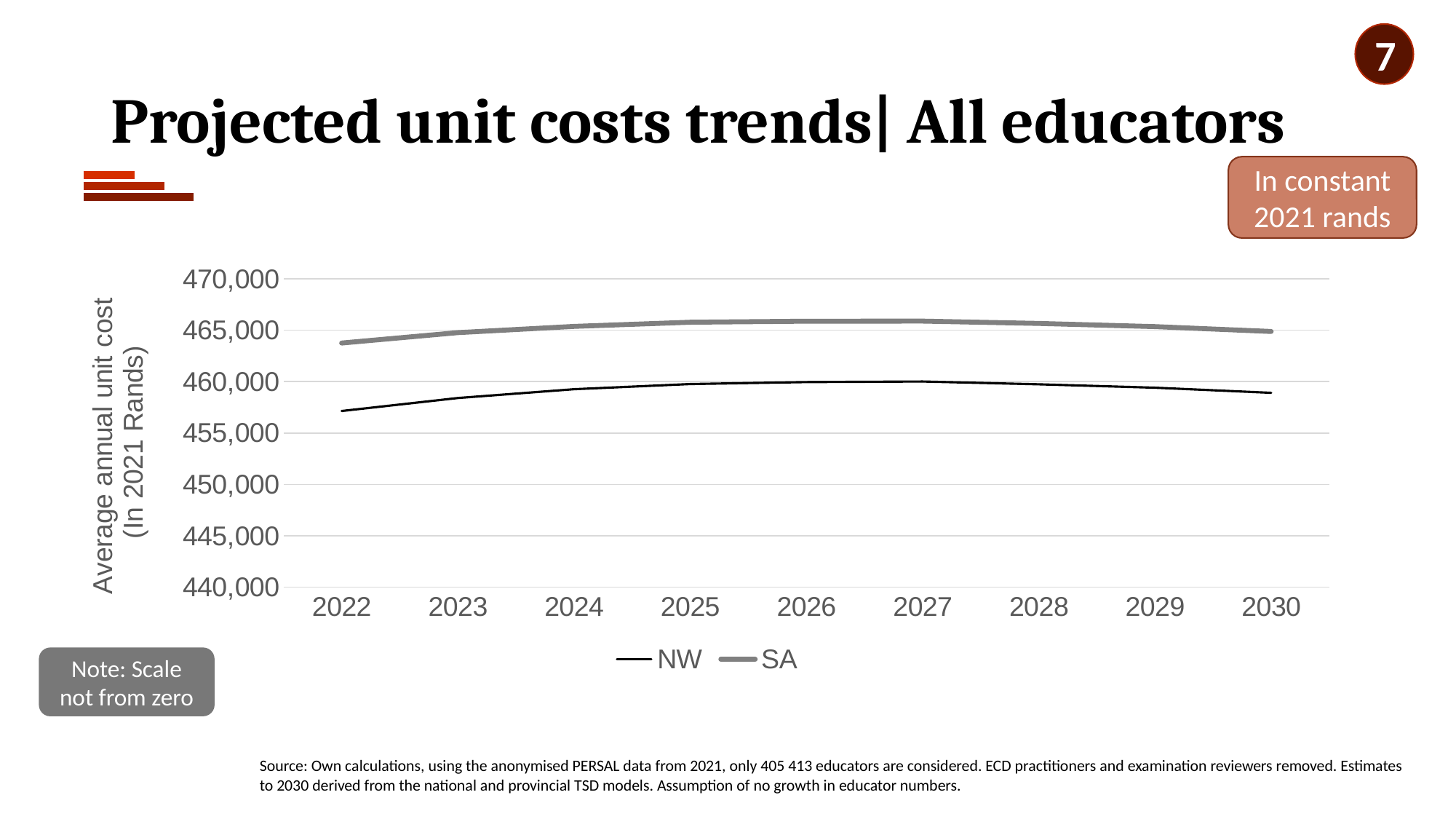
What kind of chart is shown on the slide? Line chart How many series does the chart legend list? 2 Does the NW line rise or fall between 2022 and 2025? rise How many years are plotted along the x axis? 9 What is the y-axis title of the chart? Average annual unit cost (In 2021 Rands) Is the value for SA in 2022 greater or less than 465,000? less Is the value for SA in 2022 greater or less than 460,000? greater Is the value for NW in 2030 greater or less than 455,000? greater Which series has the higher value in 2030, NW or SA? SA Which series has the higher value in 2022, NW or SA? SA Does the SA line rise or fall between 2027 and 2030? fall